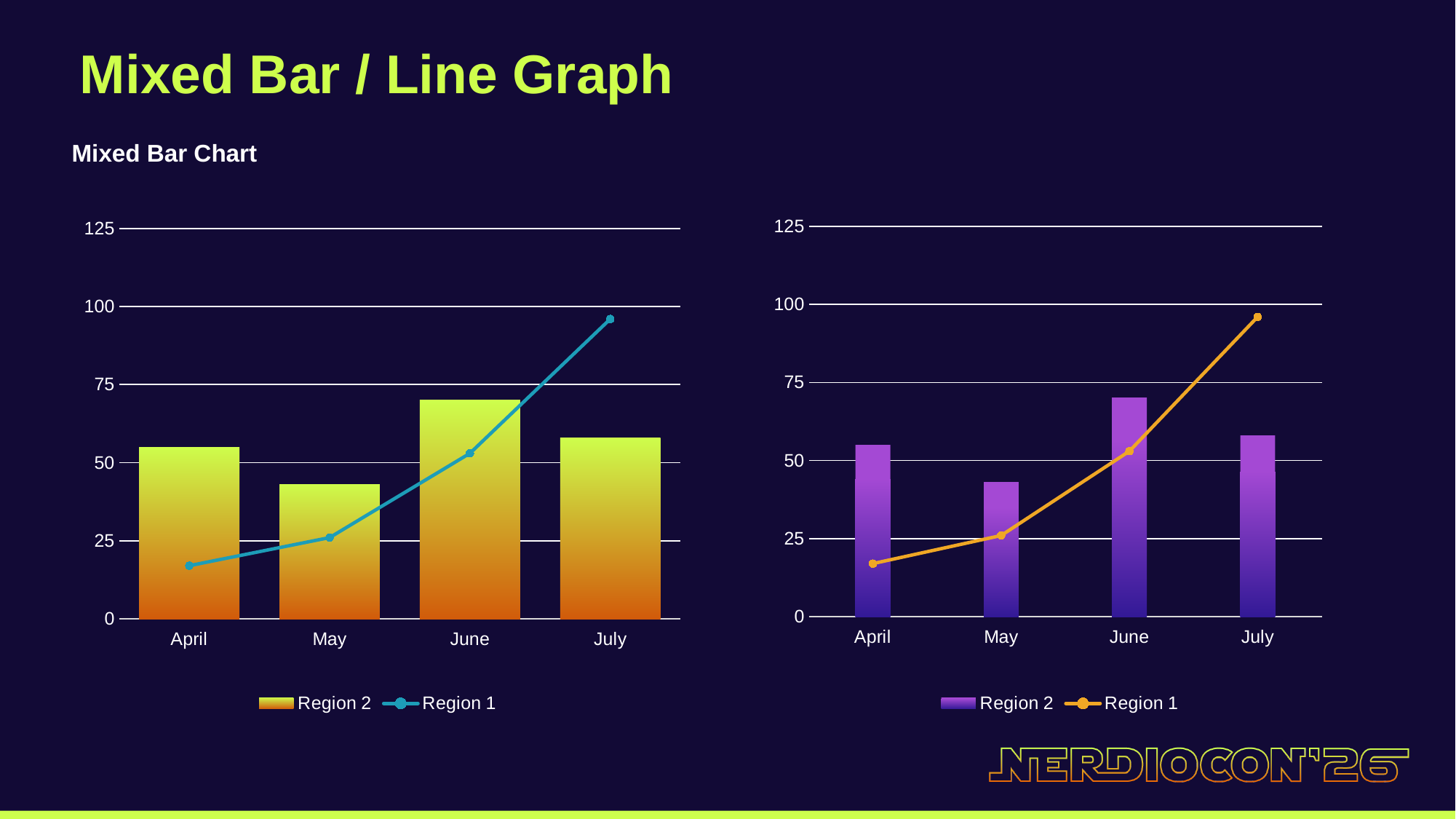
In the right chart, is the Region 1 value for July greater or less than 75? greater In the left chart, is the Region 2 value for May greater or less than 50? less What colour is the Region 1 line in the right chart? orange How many months are shown on the x axis of the left chart? 4 How many series does the legend of the right chart list? 2 In the left chart, which month has the highest Region 2 bar? June In the right chart, is the Region 2 value for June greater or less than 50? greater In the left chart, which month has the lowest Region 2 bar? May In the right chart, does the Region 1 line rise or fall from April to July? rises In the left chart, which is larger in April: Region 1 or Region 2? Region 2 In the right chart, which is larger in July: Region 1 or Region 2? Region 1